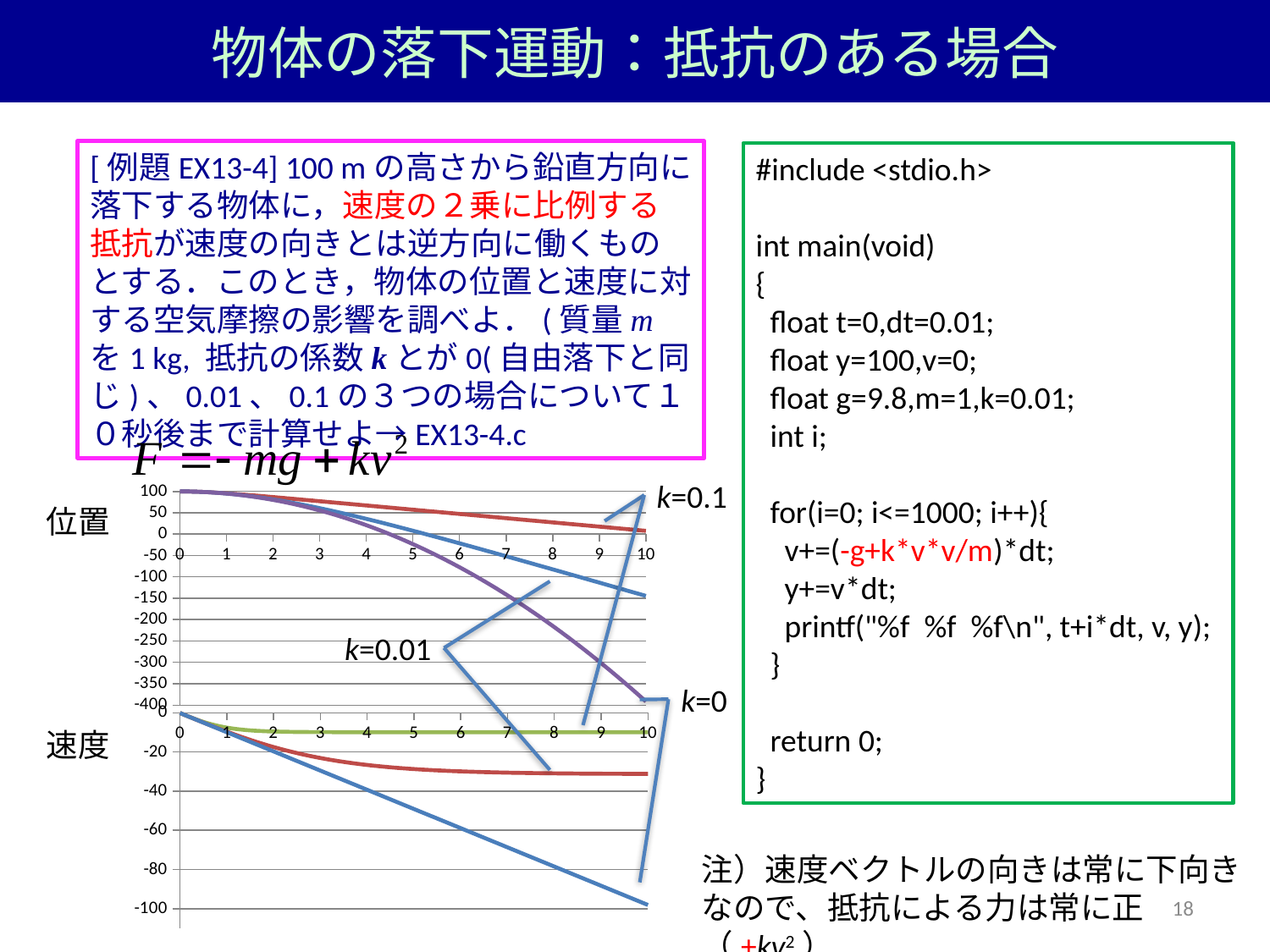
On the upper 位置 (position) chart, what is the value of the curves at x = 0? 100 On the upper 位置 (position) chart, is the value of the k=0.01 curve at x = 10 greater or less than -100? less On the lower 速度 (velocity) chart, is the value of the k=0.01 curve at x = 10 greater or less than -20? less On the lower 速度 (velocity) chart, is the value of the k=0 curve at x = 10 greater or less than -80? less How many curves are plotted on the upper 位置 (position) chart? 3 On the upper 位置 (position) chart, which curve has the lowest value at x = 10? k=0 On the lower 速度 (velocity) chart, what is the value of the curves at x = 0? 0 On the upper 位置 (position) chart, do the curves rise or fall as x increases from 0 to 10? fall On the lower 速度 (velocity) chart, which curve has the highest value at x = 10? k=0.1 On the upper 位置 (position) chart, at x = 5, which curve has the larger value, k=0.1 or k=0? k=0.1 What kind of chart is the upper chart labelled 位置 (position)? line chart